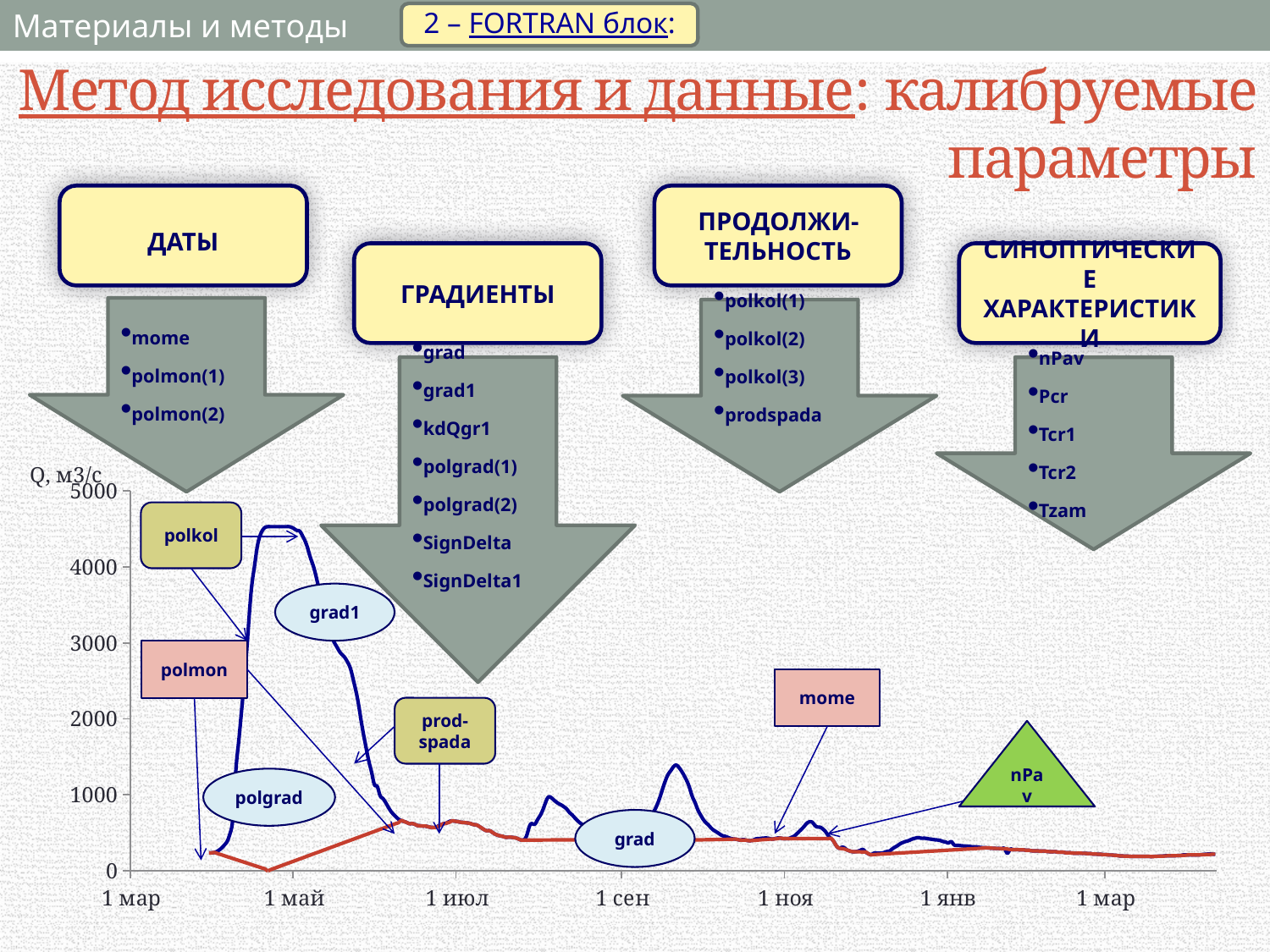
How many date labels are shown along the horizontal axis of the chart? 7 Is the value of the blue line at 1 мар (the start of the chart) greater or less than 1000? less What is the highest value shown on the vertical axis of the chart? 5000 What is the first date label on the horizontal axis of the chart? 1 мар Which line reaches the higher peak value, the blue line or the red line? the blue line What kind of chart is shown at the bottom of the slide? line chart Is the peak value of the red line (near 1 июл) greater or less than 1000? less What is the label on the vertical axis of the chart? Q, м3/с Is the peak of the blue line between 1 сен and 1 ноя greater or less than 1000? greater Does the blue line rise or fall between 1 май and 1 июл? fall